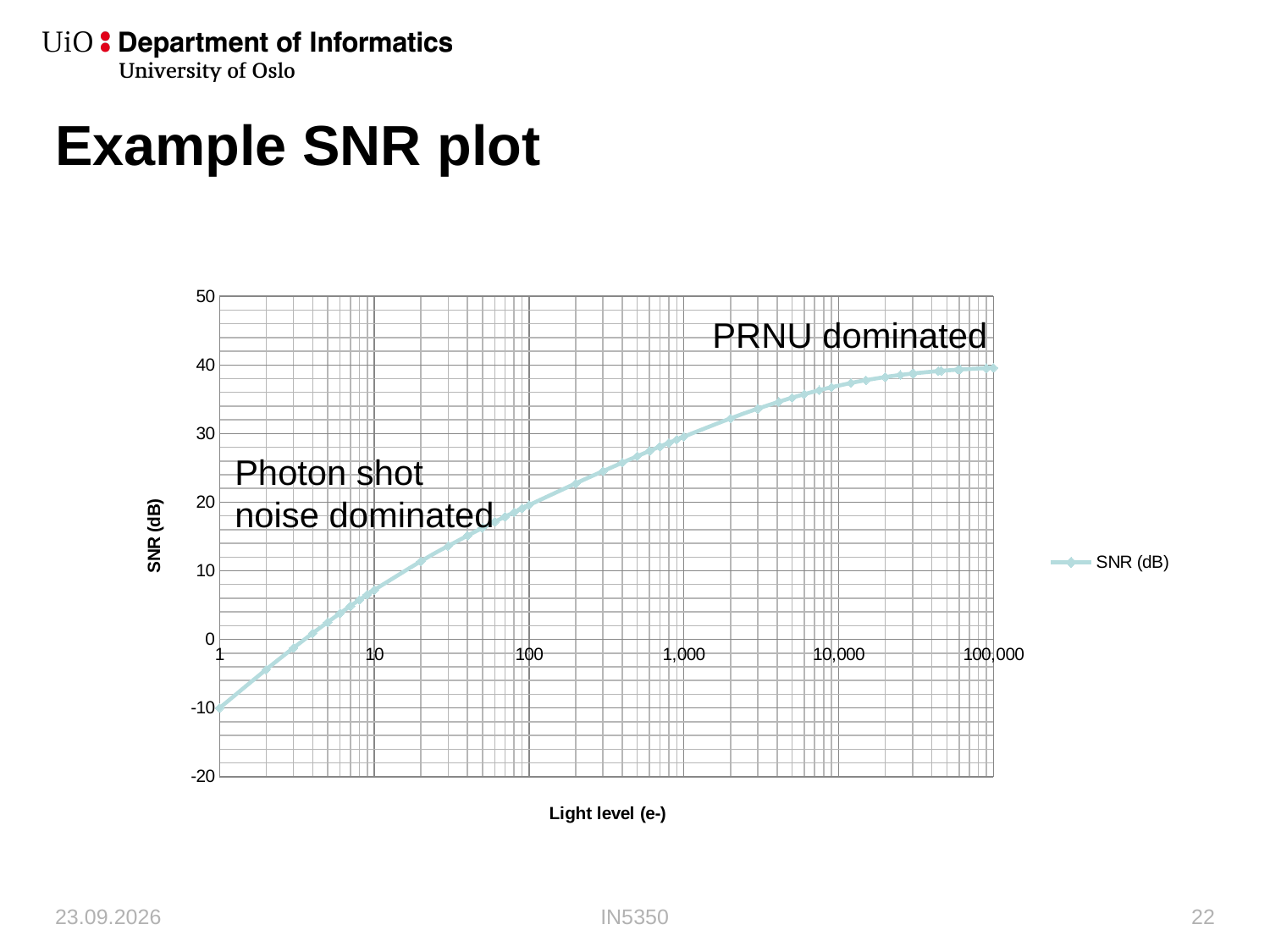
Is the SNR value at a light level of 10,000 greater or less than 40? less At which light level on the x axis is the SNR lowest? 1 Is the SNR value at a light level of 100 greater or less than 10? greater What is the name of the series shown in the legend? SNR (dB) Is the SNR value at a light level of 10 greater or less than 0? greater At which light level on the x axis is the SNR highest? 100,000 Does the SNR rise or fall as the light level increases along the x axis? rise How many series does the legend list? 1 Which region label is placed at the high light-level end of the curve? PRNU dominated What kind of chart is shown on the slide? line chart